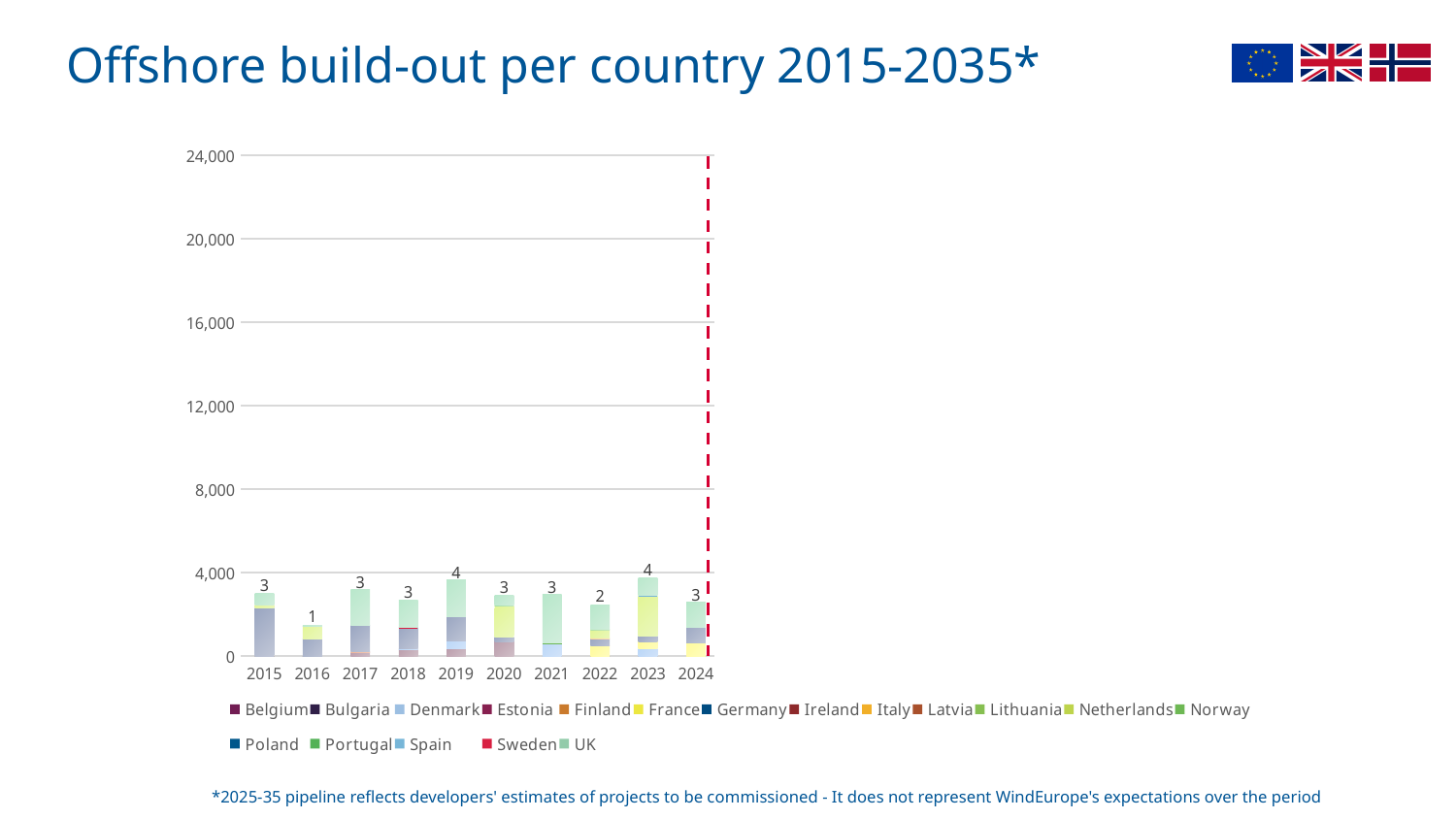
What is the highest value shown on the y axis of the chart? 24,000 Which year has the larger total bar, 2015 or 2016? 2015 Is the total bar for 2023 greater or less than 8,000? less What is the data label printed above the bar for 2016? 1 What is the data label printed above the bar for 2022? 2 How many years (bars) are shown on the x axis of the chart? 10 What is the data label printed above the bar for 2019? 4 What kind of chart is shown on the slide? Stacked bar chart Is the total bar for 2016 greater or less than 4,000? less What is the title of the chart? Offshore build-out per country 2015-2035* How many countries does the chart legend list? 18 Which year has the lowest total bar in the chart? 2016